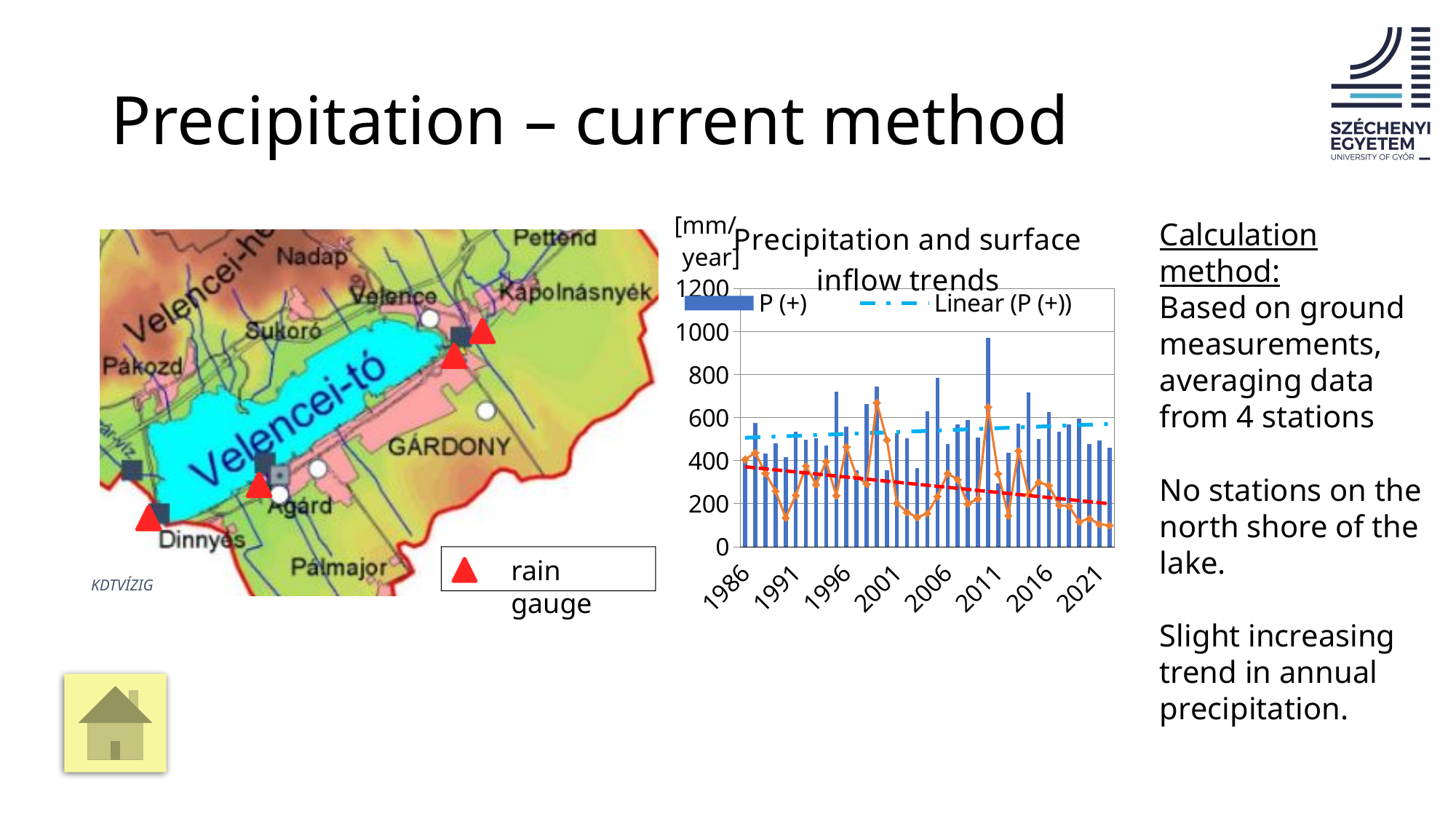
How many year labels are shown on the horizontal axis of the chart? 8 What is the first year labelled on the horizontal axis of the chart? 1986 How many series does the chart legend list? 2 What are the two entries in the chart legend? P (+) and Linear (P (+)) Is the P (+) bar for 2011 greater or less than 800? less Which year has the tallest P (+) bar in the chart? 2010 Is the P (+) bar for 2021 greater or less than 600? less Does the Linear (P (+)) trend line rise or fall from 1986 to 2021? rises What is the title of the chart on the slide? Precipitation and surface inflow trends What is the highest value shown on the vertical axis of the chart? 1200 What unit is shown on the vertical axis of the chart? [mm/year]